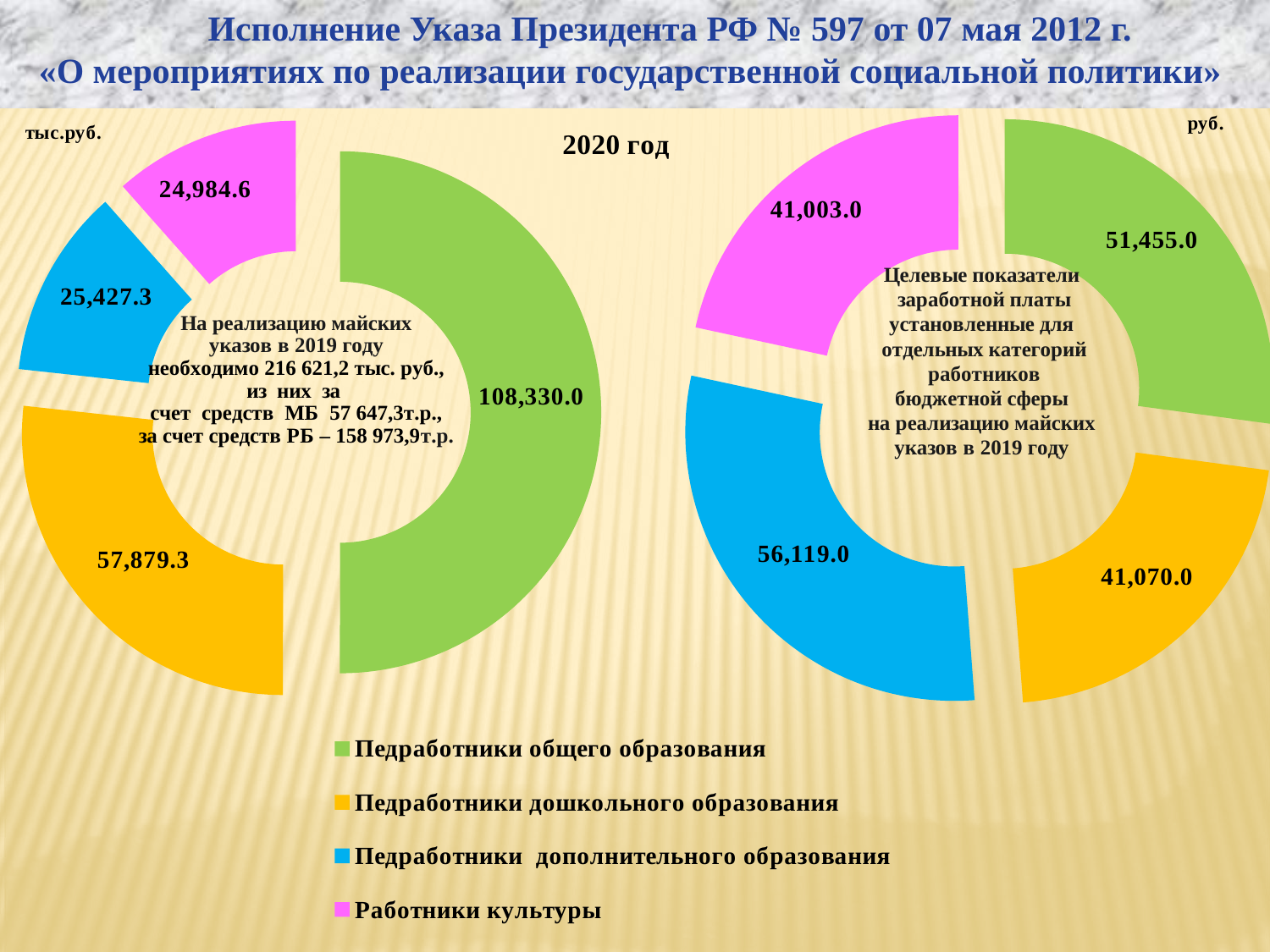
On the left doughnut chart, what is the value for Работники культуры? 24,984.6 How many categories does the legend list? 4 On the right doughnut chart, which category has the largest value? Педработники дополнительного образования On the right doughnut chart, what is the value for Педработники дополнительного образования? 56,119.0 On the left doughnut chart, what is the difference between the values for Педработники общего образования and Педработники дошкольного образования? 50,450.7 On the right doughnut chart, what is the value for Педработники дошкольного образования? 41,070.0 On the right doughnut chart, which is larger: the value for Педработники общего образования or for Работники культуры? Педработники общего образования On the right doughnut chart, what is the difference between the values for Педработники дополнительного образования and Педработники общего образования? 4,664.0 On the left doughnut chart, which category has the largest value? Педработники общего образования On the left doughnut chart, which category has the smallest value? Работники культуры On the left doughnut chart, what is the value for Педработники общего образования? 108,330.0 What type of chart is shown on the left side of the slide? Doughnut (pie) chart